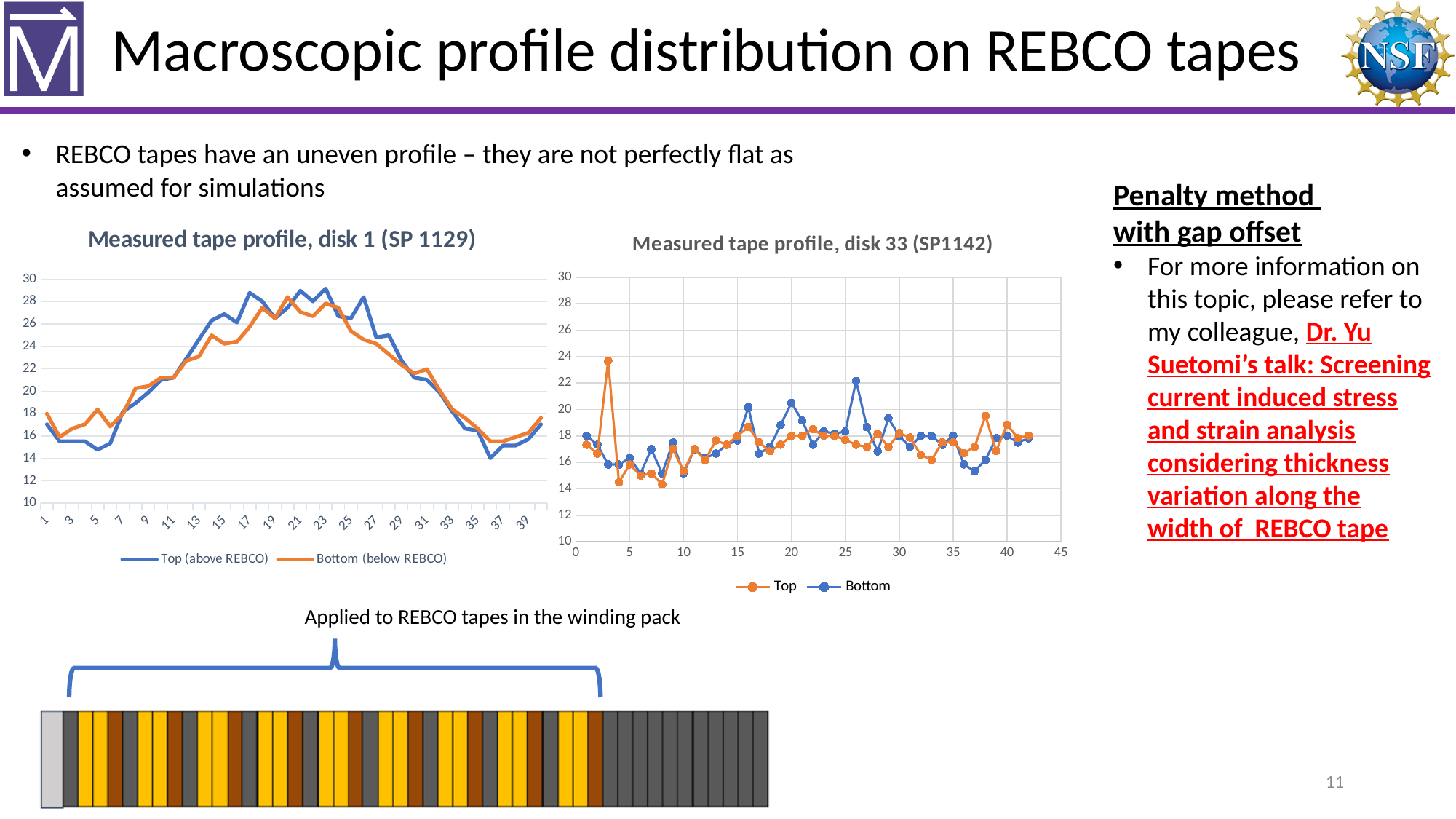
In the 'Measured tape profile, disk 1 (SP 1129)' chart, is the Top (above REBCO) value at x = 37 greater or less than 16? less In the 'Measured tape profile, disk 33 (SP1142)' chart, is the Top value at x = 3 greater or less than 22? greater In the 'Measured tape profile, disk 1 (SP 1129)' chart, does the Top (above REBCO) series rise or fall between x = 23 and x = 37? fall In the 'Measured tape profile, disk 33 (SP1142)' chart, is the Bottom value at x = 26 greater or less than 20? greater What are the two legend entries of the 'Measured tape profile, disk 1 (SP 1129)' chart? Top (above REBCO) and Bottom (below REBCO) In the 'Measured tape profile, disk 33 (SP1142)' chart, which colour is used for the Bottom series? blue What kind of chart is the 'Measured tape profile, disk 1 (SP 1129)' chart? line chart In the 'Measured tape profile, disk 33 (SP1142)' chart, at x = 3, which series has the higher value, Top or Bottom? Top How many series does the legend of the 'Measured tape profile, disk 33 (SP1142)' chart list? 2 In the 'Measured tape profile, disk 1 (SP 1129)' chart, at x = 37, which series has the higher value, Top (above REBCO) or Bottom (below REBCO)? Bottom (below REBCO)